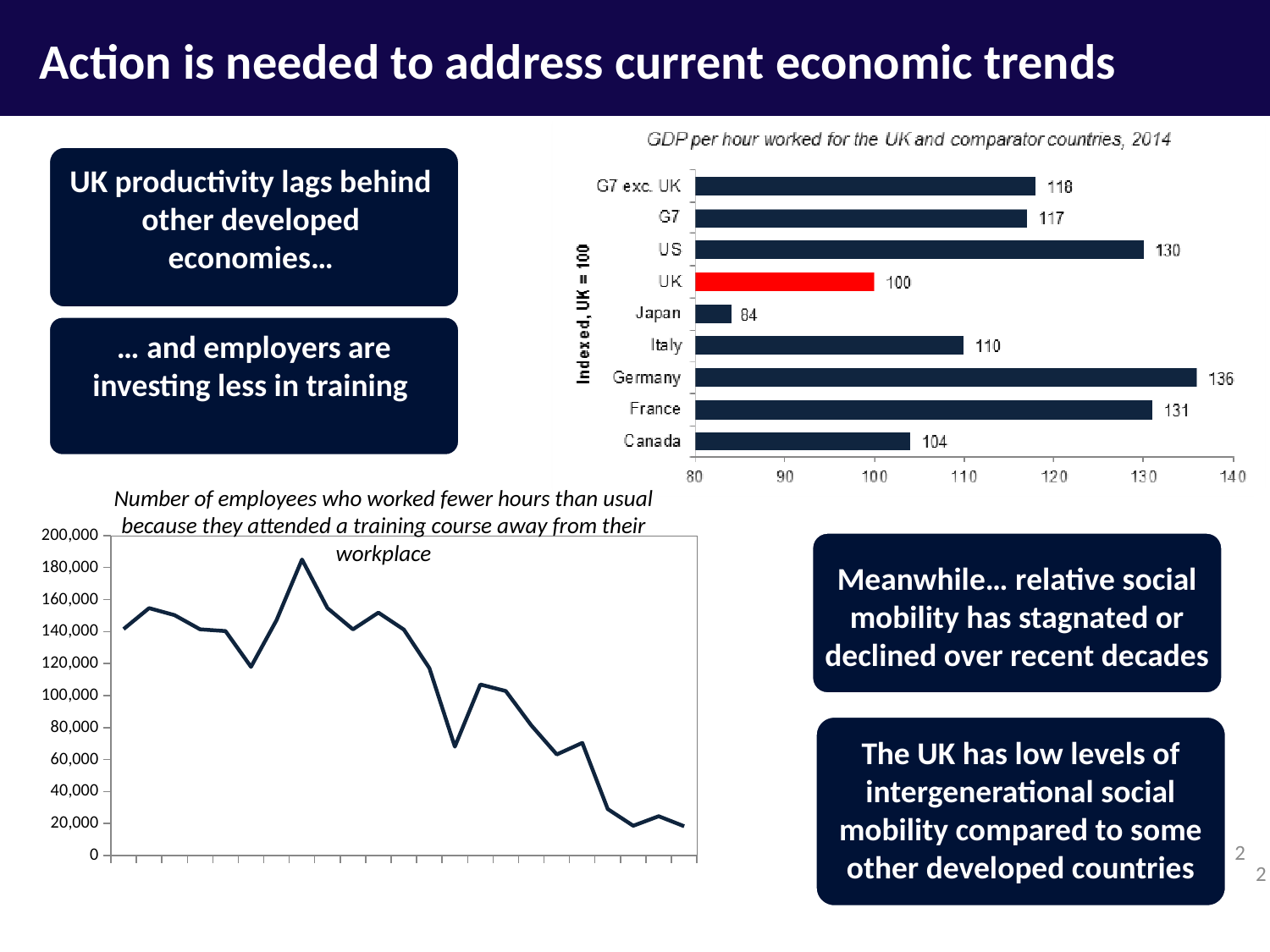
In the chart about employees who attended a training course away from their workplace, do the values overall rise or fall along the x axis? Fall What kind of chart is the chart about employees who attended a training course away from their workplace? Line chart In the GDP per hour worked chart, what is the value for Japan? 84 In the GDP per hour worked chart, what is the value for France? 131 In the GDP per hour worked chart, what is the value for Germany? 136 In the GDP per hour worked chart, what is the difference between the US and the UK values? 30 In the GDP per hour worked chart, which country has the highest value? Germany In the GDP per hour worked chart, which is larger, the value for Canada or the value for Italy? Italy How many categories are shown in the GDP per hour worked chart? 9 In the GDP per hour worked chart, which country has the lowest value? Japan What kind of chart is the GDP per hour worked chart? Bar chart In the GDP per hour worked chart, which bar is coloured red? UK